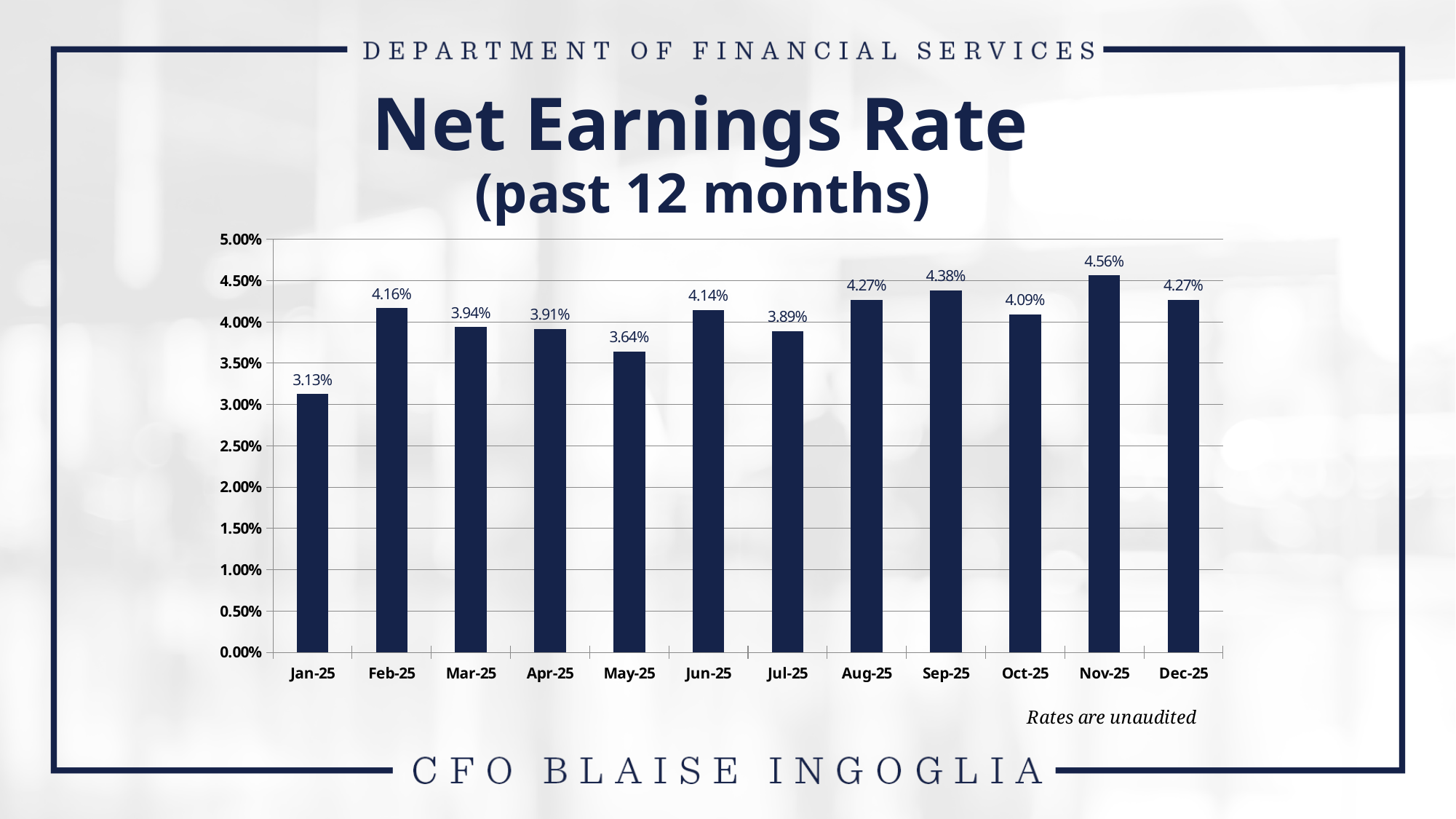
What kind of chart is shown on the slide? Bar chart Which month has the highest net earnings rate? Nov-25 Which month has the lowest net earnings rate? Jan-25 What is the net earnings rate for Sep-25? 4.38% What is the difference between the net earnings rate in Dec-25 and Oct-25? 0.18% What is the net earnings rate for May-25? 3.64% What is the title of the chart? Net Earnings Rate (past 12 months) How many months are shown on the chart? 12 What is the difference between the net earnings rate in Nov-25 and Jan-25? 1.43% What is the net earnings rate for Jan-25? 3.13% Which is larger, the net earnings rate for Feb-25 or for Mar-25? Feb-25 Is the net earnings rate for Jul-25 greater or less than 4.00%? less